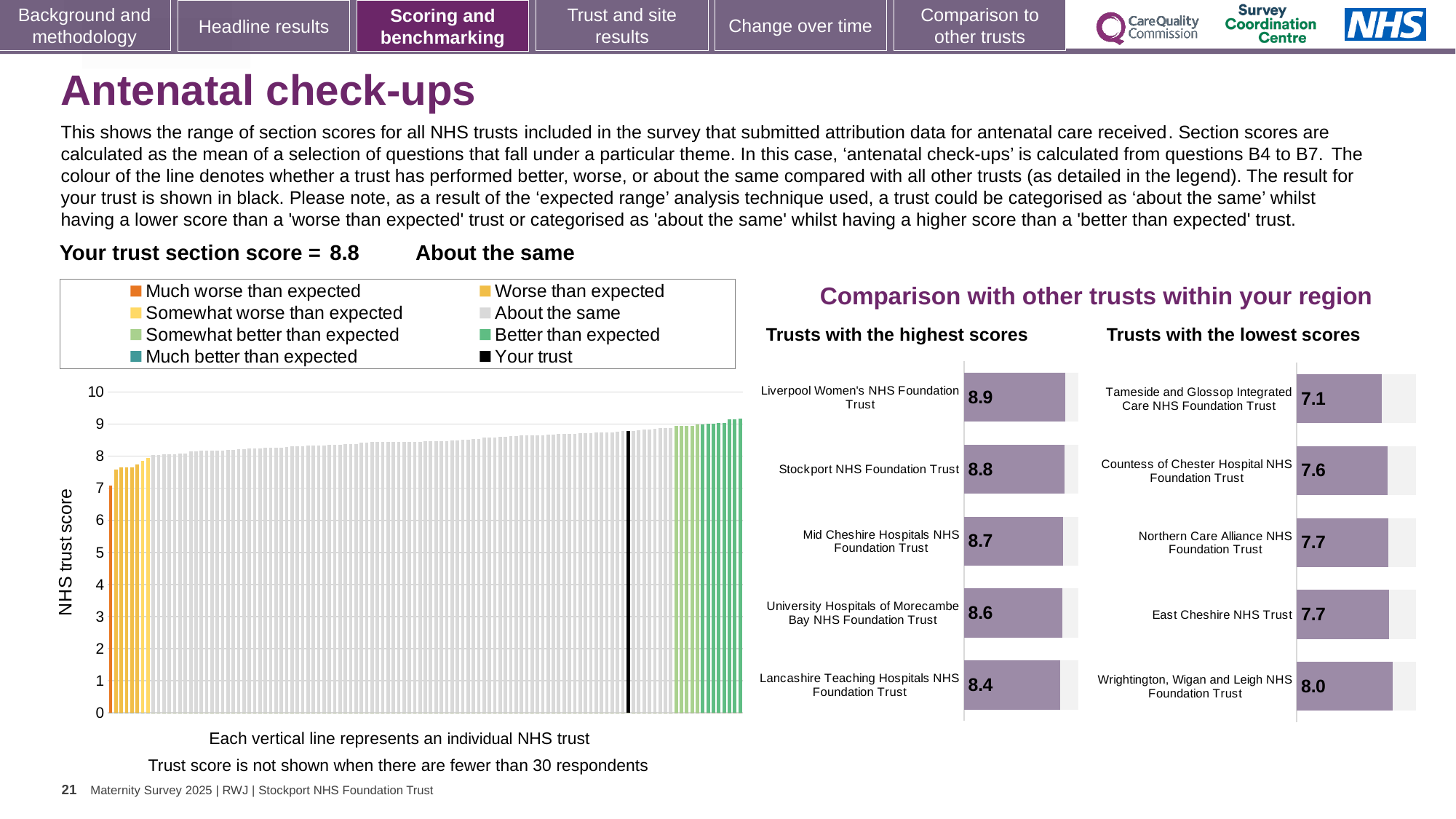
In the 'Trusts with the lowest scores' chart, what is the score for Tameside and Glossop Integrated Care NHS Foundation Trust? 7.1 In the 'Trusts with the lowest scores' chart, what is the difference between the scores of Wrightington, Wigan and Leigh NHS Foundation Trust and Tameside and Glossop Integrated Care NHS Foundation Trust? 0.9 How many trusts are shown in the 'Trusts with the highest scores' chart? 5 In the large chart on the left, is the value for the black 'Your trust' bar greater or less than 8? greater In the 'Trusts with the highest scores' chart, what is the difference between the scores of Liverpool Women's NHS Foundation Trust and Lancashire Teaching Hospitals NHS Foundation Trust? 0.5 In the 'Trusts with the highest scores' chart, which trust has the lowest score? Lancashire Teaching Hospitals NHS Foundation Trust In the 'Trusts with the highest scores' chart, what is the score for Lancashire Teaching Hospitals NHS Foundation Trust? 8.4 How many entries does the legend of the large chart on the left list? 8 In the 'Trusts with the lowest scores' chart, which has the higher score: Countess of Chester Hospital NHS Foundation Trust or Tameside and Glossop Integrated Care NHS Foundation Trust? Countess of Chester Hospital NHS Foundation Trust In the 'Trusts with the lowest scores' chart, which trust has the highest score? Wrightington, Wigan and Leigh NHS Foundation Trust In the large chart on the left, do the bar values rise or fall from left to right? rise In the 'Trusts with the highest scores' chart, what is the score for Liverpool Women's NHS Foundation Trust? 8.9